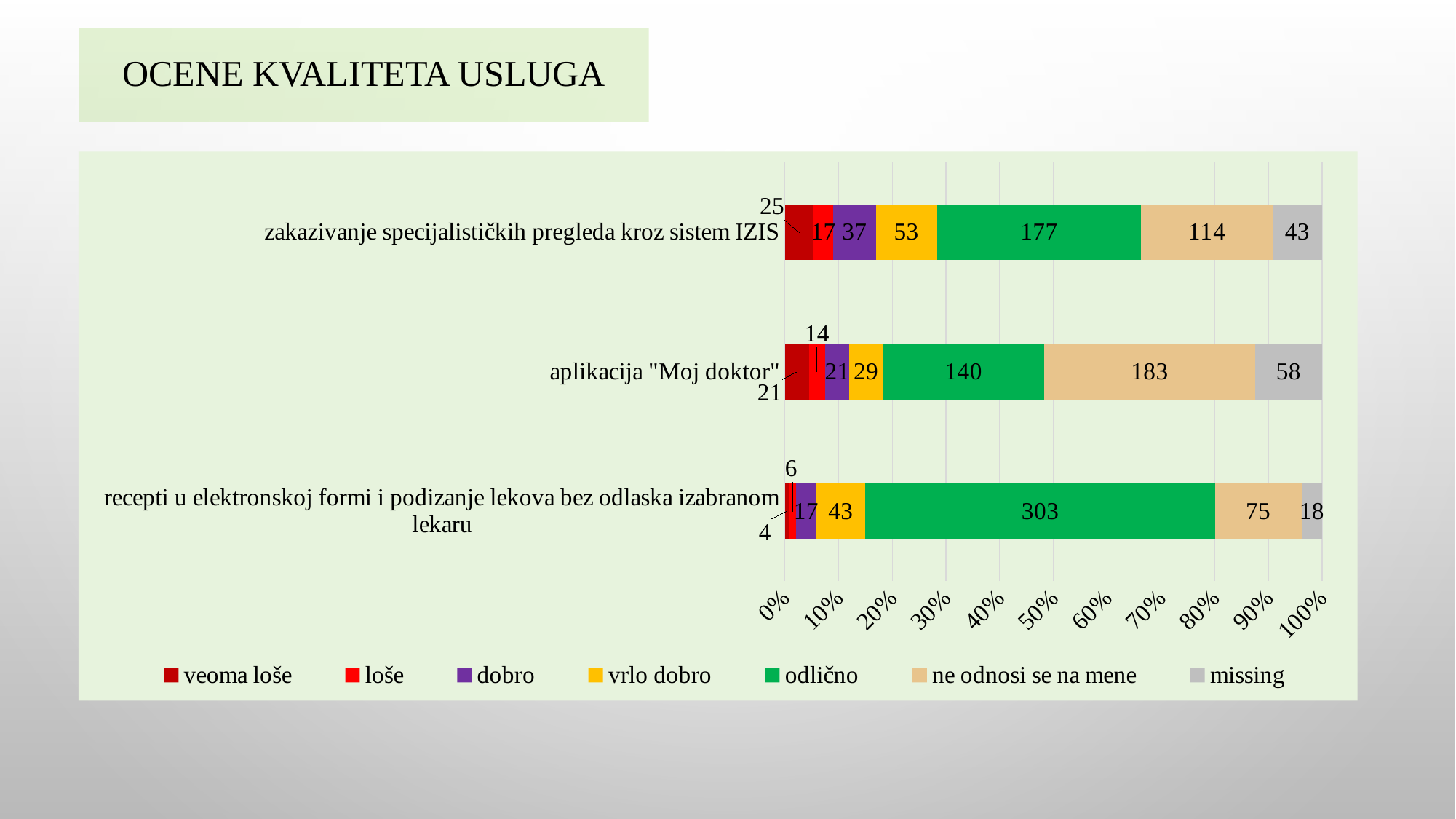
What is the difference between the "odlično" values for "recepti u elektronskoj formi i podizanje lekova bez odlaska izabranom lekaru" and "aplikacija "Moj doktor""? 163 What is the value of "ne odnosi se na mene" for "aplikacija "Moj doktor""? 183 Which is larger: "ne odnosi se na mene" for "zakazivanje specijalističkih pregleda kroz sistem IZIS" or for "aplikacija "Moj doktor""? aplikacija "Moj doktor" Which category has the highest value for "odlično"? recepti u elektronskoj formi i podizanje lekova bez odlaska izabranom lekaru What is the value of "missing" for "aplikacija "Moj doktor""? 58 Which category has the lowest value for "missing"? recepti u elektronskoj formi i podizanje lekova bez odlaska izabranom lekaru What is the value of "vrlo dobro" for "recepti u elektronskoj formi i podizanje lekova bez odlaska izabranom lekaru"? 43 How many categories (bars) does the chart show? 3 What is the total of all segments in the bar for "zakazivanje specijalističkih pregleda kroz sistem IZIS"? 466 How many series does the legend list? 7 What kind of chart is shown on the slide? stacked bar chart What is the value of "odlično" for "zakazivanje specijalističkih pregleda kroz sistem IZIS"? 177